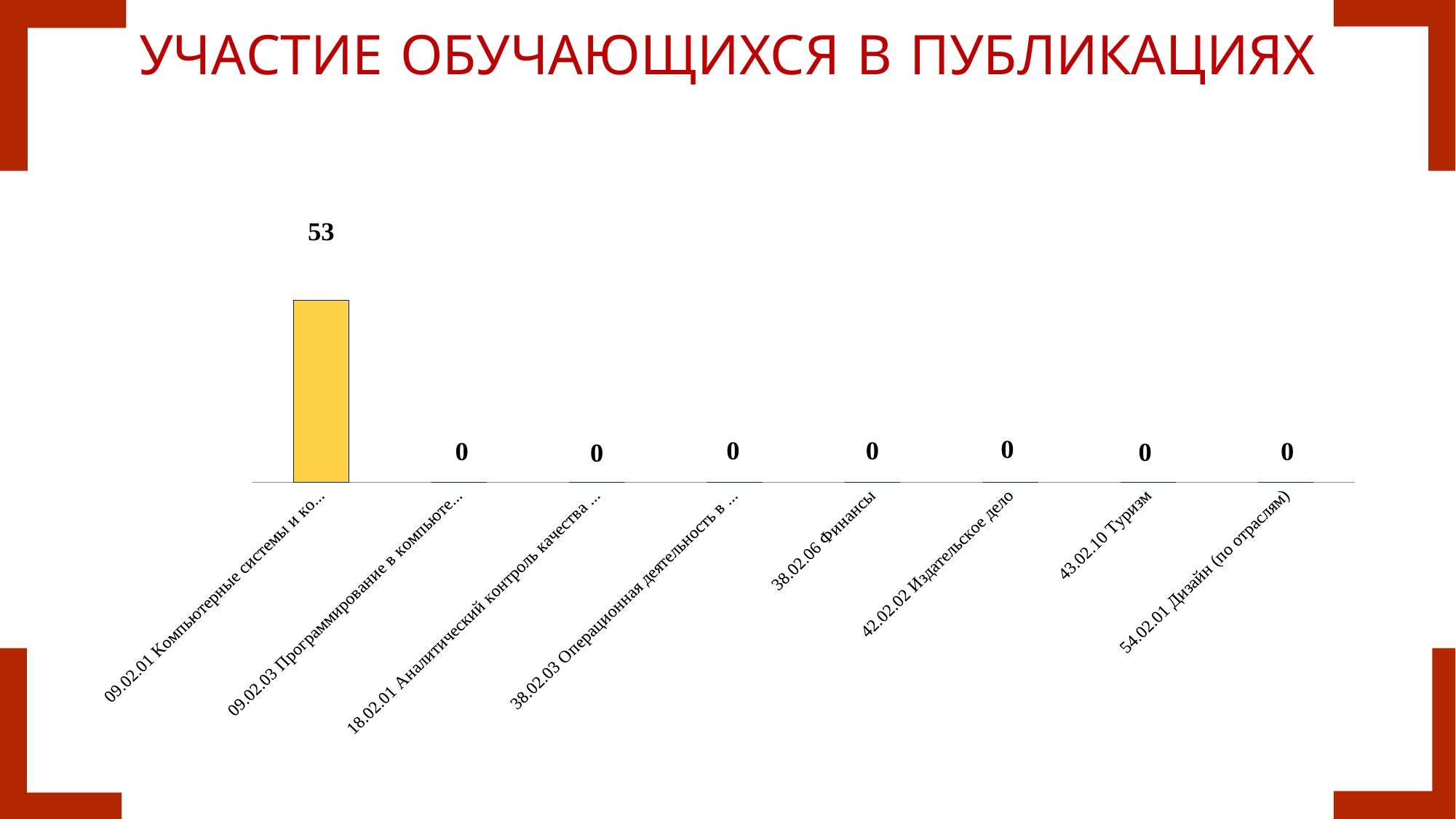
What is the difference between the value for 09.02.01 Компьютерные системы and the value for 38.02.06 Финансы? 53 What is the value for 43.02.10 Туризм? 0 What is the value for 38.02.06 Финансы? 0 What is the value for 42.02.02 Издательское дело? 0 How many categories have a value of 0? 7 How many categories are shown on the x axis? 8 Which category has the highest value? 09.02.01 Компьютерные системы What is the value for 54.02.01 Дизайн (по отраслям)? 0 What is the value for 09.02.01 Компьютерные системы? 53 What type of chart is shown on the slide? bar chart Which is larger, the value for 09.02.01 Компьютерные системы or the value for 43.02.10 Туризм? 09.02.01 Компьютерные системы What is the title of the slide? УЧАСТИЕ ОБУЧАЮЩИХСЯ В ПУБЛИКАЦИЯХ